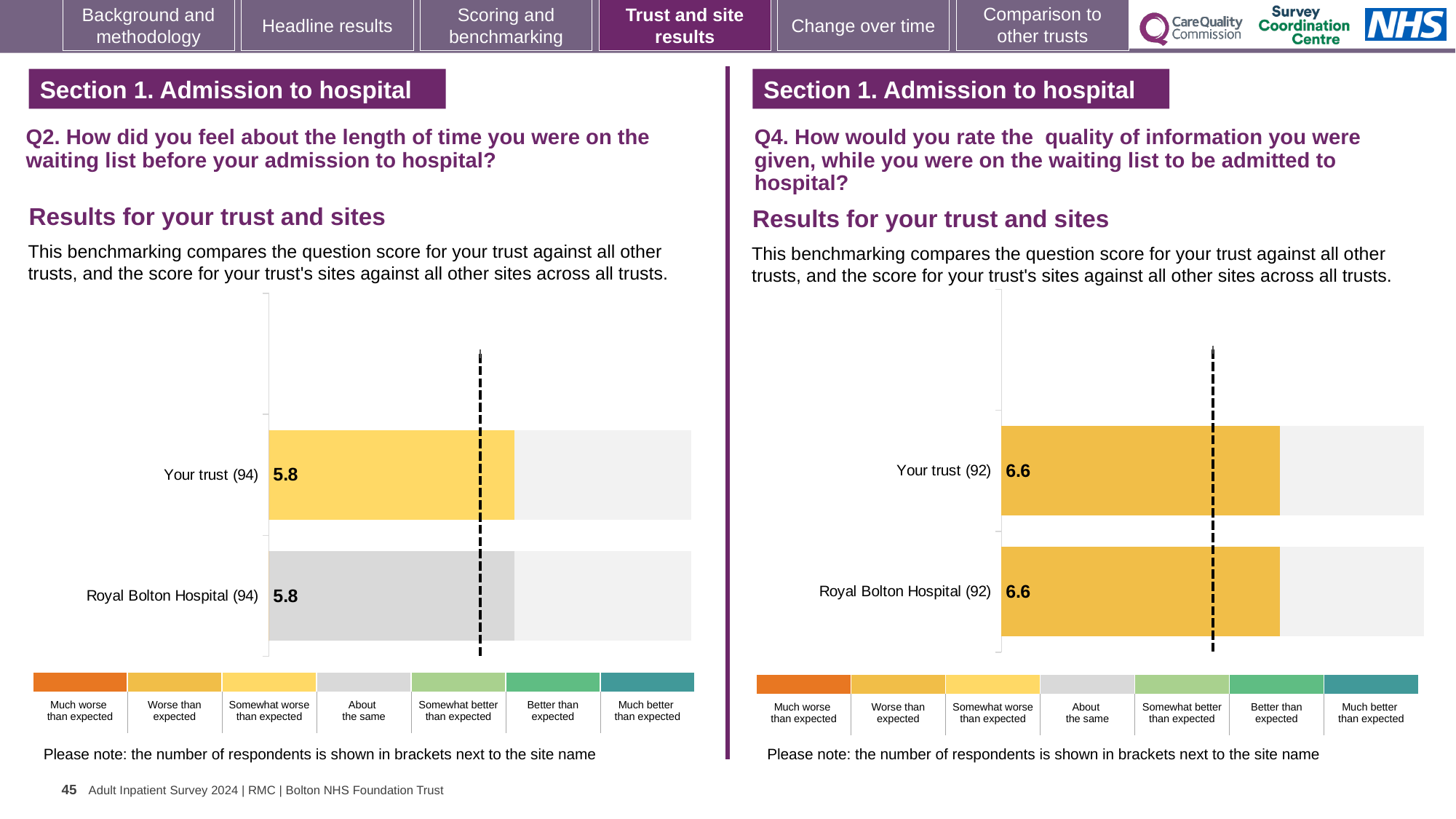
In the Q4 chart on the right, what is the score for Royal Bolton Hospital? 6.6 In the Q4 chart on the right, what is the score for Your trust? 6.6 In the Q2 chart on the left, what is the difference between the score for Your trust and the score for Royal Bolton Hospital? 0 What kind of chart is the Q2 chart on the left? Bar chart In the Q2 chart on the left, what is the score for Royal Bolton Hospital? 5.8 How many bars are plotted in the Q4 chart on the right? 2 In the Q4 chart on the right, how many respondents are shown in brackets for Royal Bolton Hospital? 92 In the Q4 chart on the right, what is the difference between the score for Your trust and the score for Royal Bolton Hospital? 0 Is the score for Your trust in the Q4 chart on the right larger than the score for Your trust in the Q2 chart on the left? Yes In the Q2 chart on the left, what is the score for Your trust? 5.8 In the Q2 chart on the left, how many respondents are shown in brackets for Your trust? 94 How many bars are plotted in the Q2 chart on the left? 2